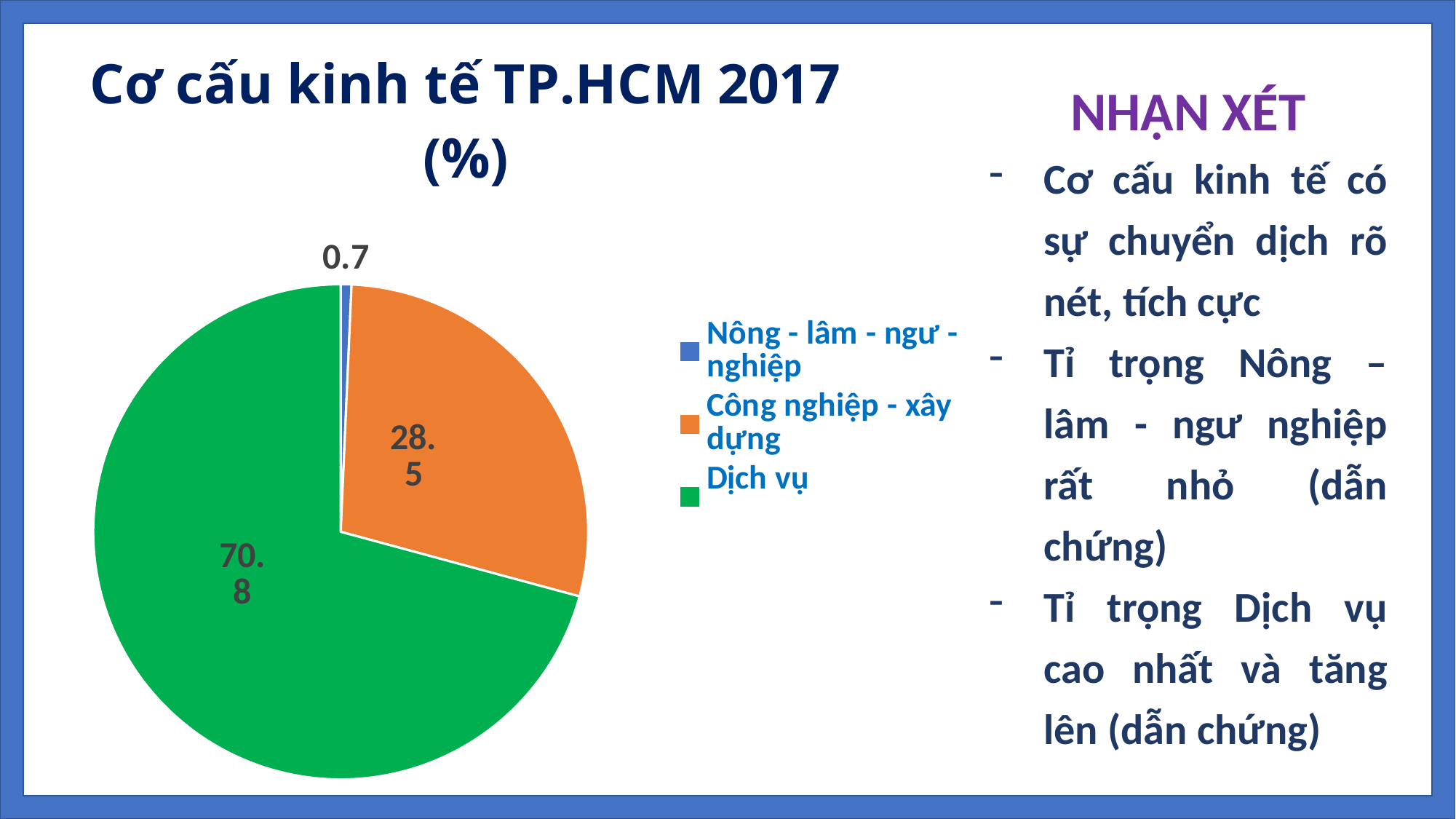
What is the value for Dịch vụ in the pie chart? 70.8 What kind of chart is shown on the slide? pie chart What colour is the slice for Dịch vụ? green Which is larger, the value for Công nghiệp - xây dựng or the value for Nông - lâm - ngư - nghiệp? Công nghiệp - xây dựng What is the difference between the values for Công nghiệp - xây dựng and Nông - lâm - ngư - nghiệp? 27.8 What is the title of the chart? Cơ cấu kinh tế TP.HCM 2017 (%) What is the value for Nông - lâm - ngư - nghiệp in the pie chart? 0.7 Which category has the smallest slice of the pie chart? Nông - lâm - ngư - nghiệp How many slices does the pie chart have? 3 What is the difference between the values for Dịch vụ and Công nghiệp - xây dựng? 42.3 Which category has the largest slice of the pie chart? Dịch vụ What is the value for Công nghiệp - xây dựng in the pie chart? 28.5